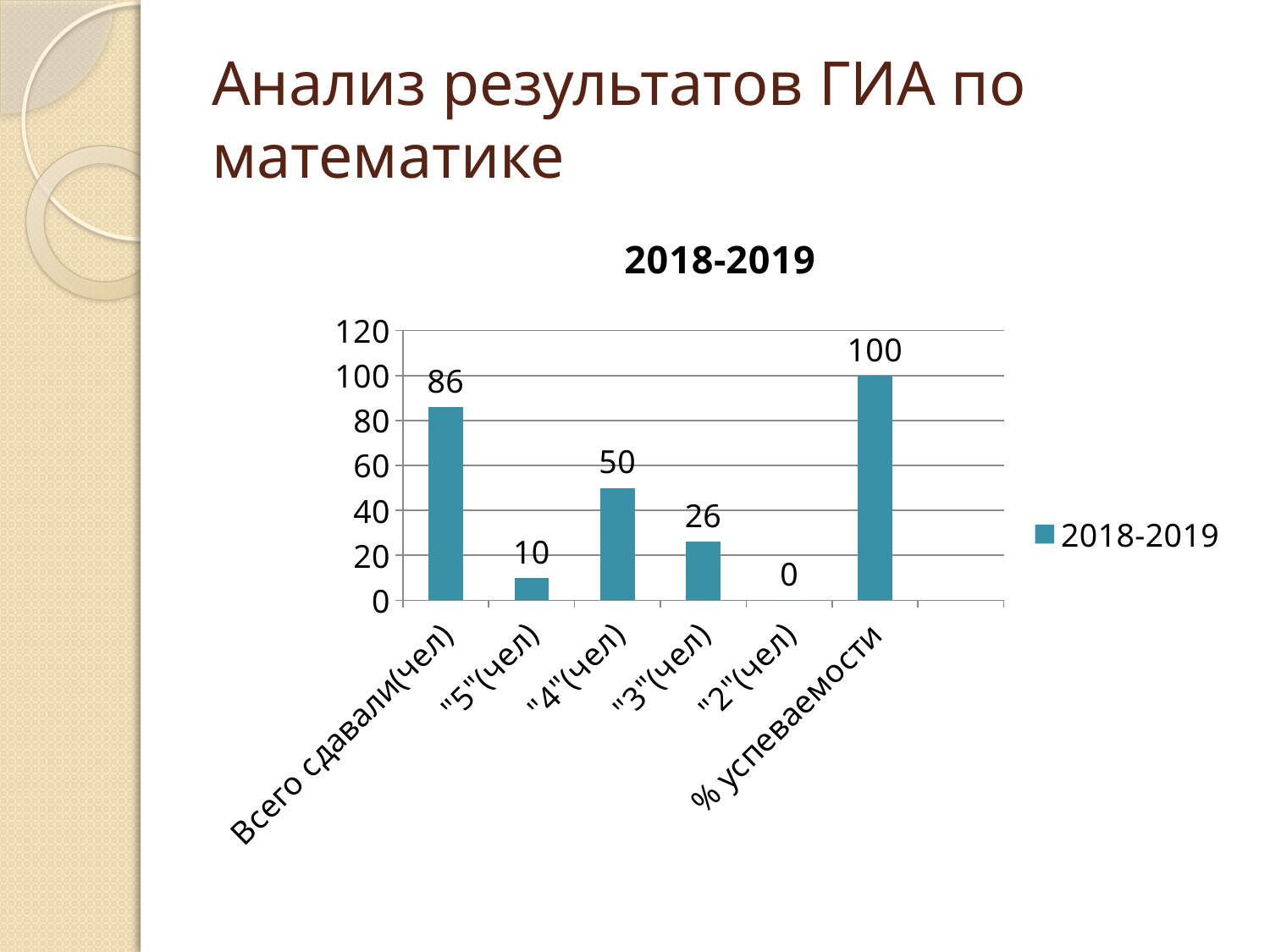
Which category has the highest value? % успеваемости What is the value for ""2"(чел)"? 0 What is the value for ""5"(чел)"? 10 How many categories are shown on the x axis? 6 Which category has the lowest value? "2"(чел) How many series does the legend list? 1 Which is larger, the value for "5"(чел) or the value for "3"(чел)? "3"(чел) What is the value for "Всего сдавали(чел)"? 86 What is the title of the chart? 2018-2019 What kind of chart is shown? bar chart What is the value for ""4"(чел)"? 50 What is the difference between the values for "4"(чел) and "3"(чел)? 24